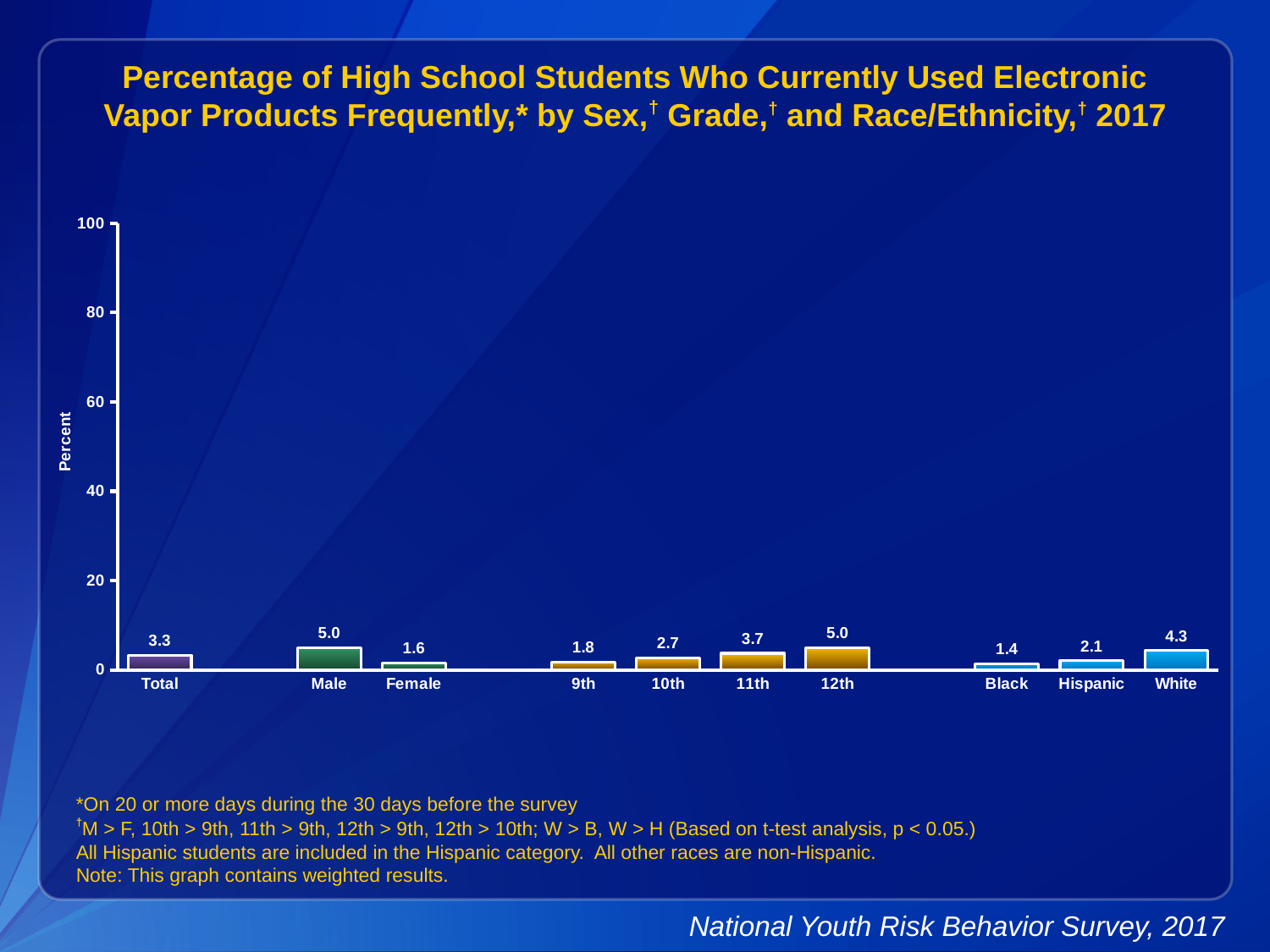
Which is larger, the value for 10th grade or the value for Hispanic? 10th Which grade has the highest value? 12th How many categories are shown on the x axis? 10 What is the difference between the values for Male and Female? 3.4 What is the value for Female? 1.6 What is the difference between the values for White and Black? 2.9 Do the values rise or fall from 9th grade to 12th grade? Rise Which category has the lowest value? Black What is the value for Hispanic? 2.1 What is the value for 11th grade? 3.7 What is the value for Total? 3.3 What kind of chart is this? Bar chart